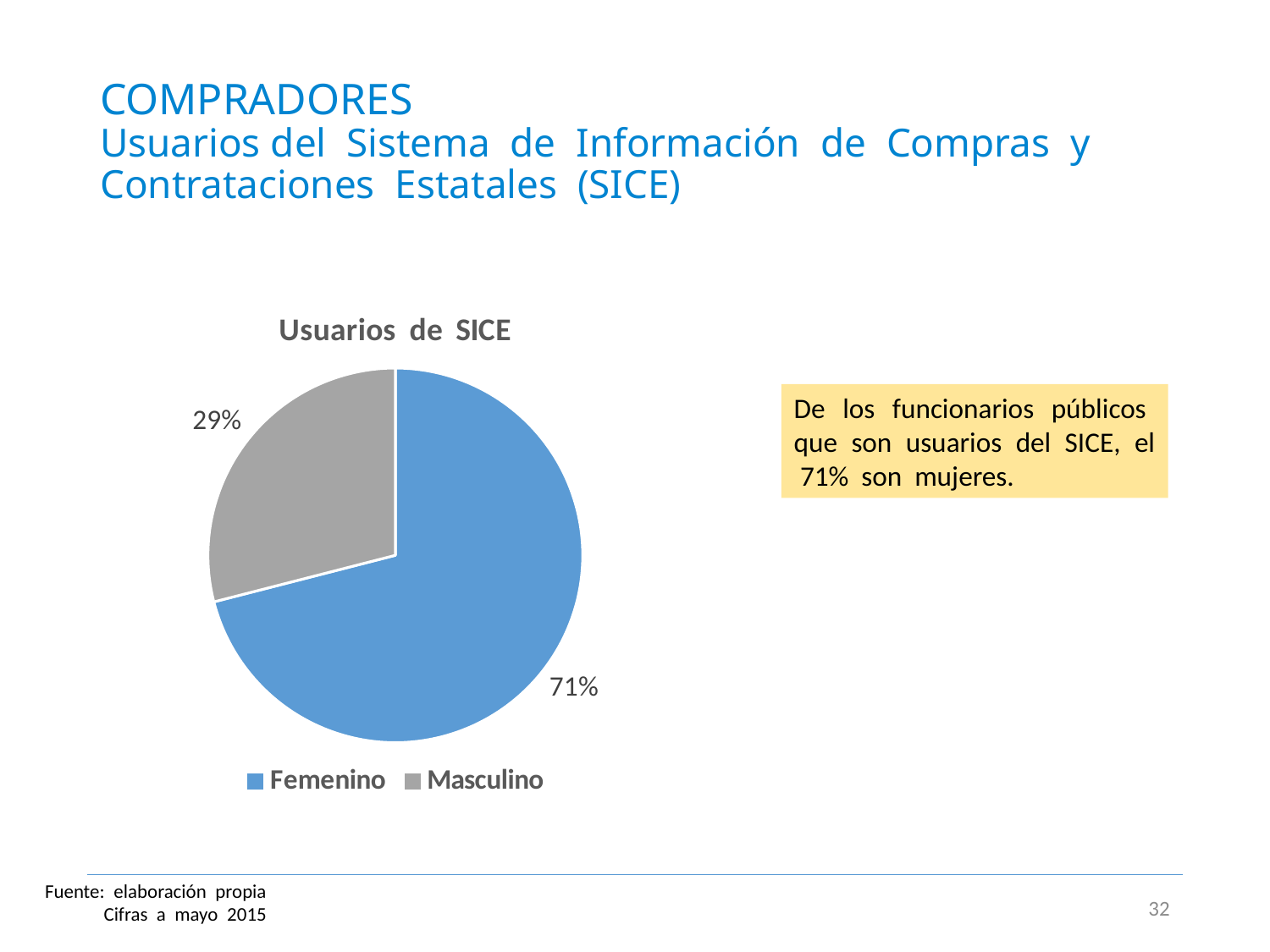
What is the difference in percentage points between the Femenino and Masculino slices? 42 What colour is the Masculino slice? Grey What share of the pie does Masculino represent? 29% How many categories does the pie chart show? 2 Is the Femenino share greater or less than 50%? greater What share of the pie does Femenino represent? 71% Which slice is larger, Femenino or Masculino? Femenino What is the title of the chart? Usuarios de SICE Which category has the largest slice of the pie? Femenino Which category has the smallest slice of the pie? Masculino What kind of chart is shown on the slide? Pie chart